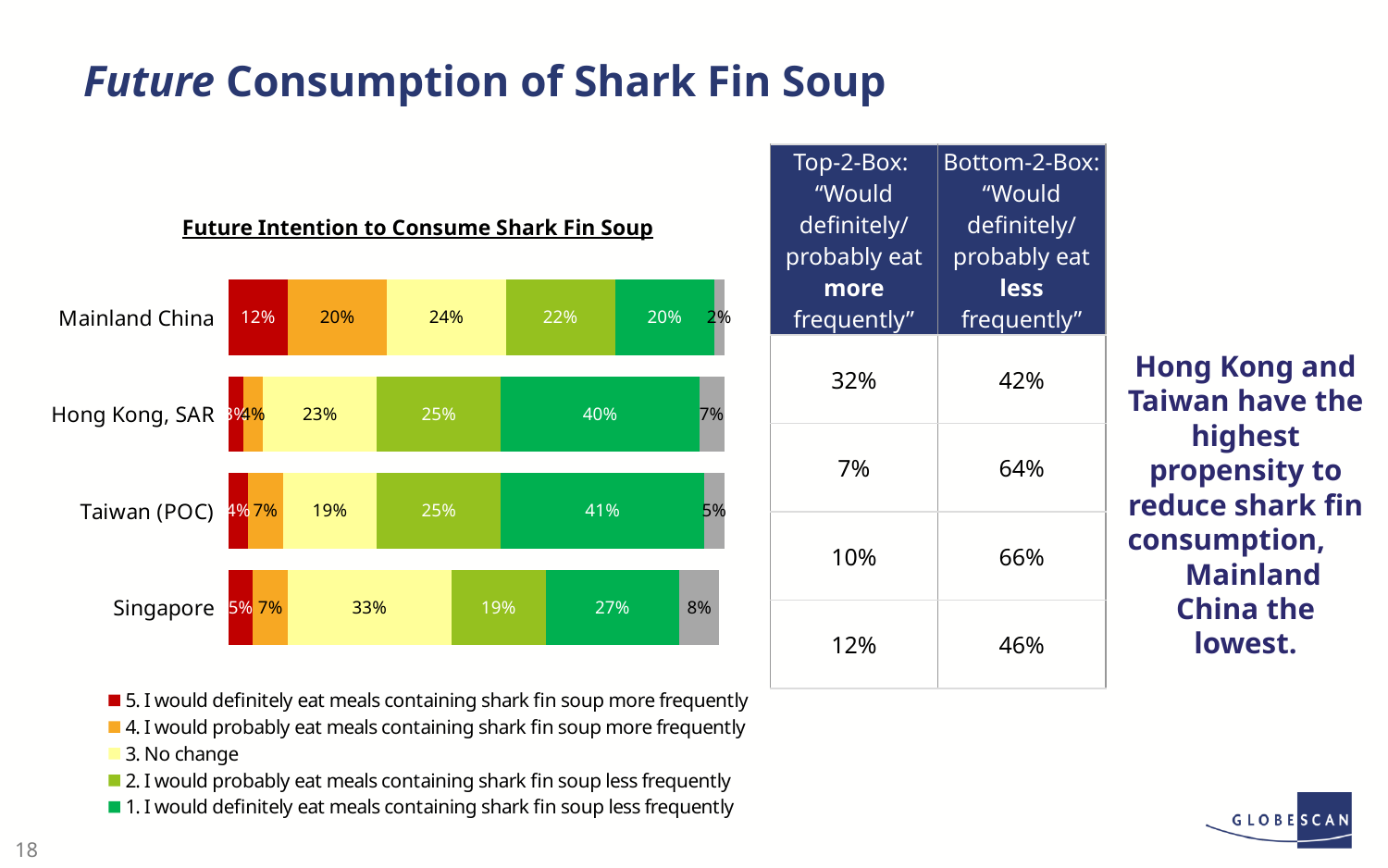
In the Future Intention to Consume Shark Fin Soup chart, which market has the highest "No change" share? Singapore How many series does the legend of the Future Intention to Consume Shark Fin Soup chart list? 5 What type of chart is used to show Future Intention to Consume Shark Fin Soup? Stacked bar chart In the Future Intention to Consume Shark Fin Soup chart, which market has the highest share saying they would definitely eat shark fin soup more frequently? Mainland China In the Future Intention to Consume Shark Fin Soup chart, what percentage of Mainland China respondents said "No change"? 24% In the Future Intention to Consume Shark Fin Soup chart, what percentage of Hong Kong, SAR respondents said they would probably eat meals containing shark fin soup less frequently? 25% In the Future Intention to Consume Shark Fin Soup chart, which market has the lowest share saying they would definitely eat shark fin soup less frequently? Mainland China How many markets are shown in the Future Intention to Consume Shark Fin Soup chart? 4 In the Future Intention to Consume Shark Fin Soup chart, what percentage of Singapore respondents said "No change"? 33% In the Future Intention to Consume Shark Fin Soup chart, how many percentage points higher is Taiwan (POC)'s "definitely eat less frequently" share than Mainland China's? 21 percentage points In the Future Intention to Consume Shark Fin Soup chart, which has a larger "definitely eat less frequently" share: Hong Kong, SAR or Singapore? Hong Kong, SAR In the Future Intention to Consume Shark Fin Soup chart, what percentage of Taiwan (POC) respondents said they would definitely eat meals containing shark fin soup less frequently? 41%